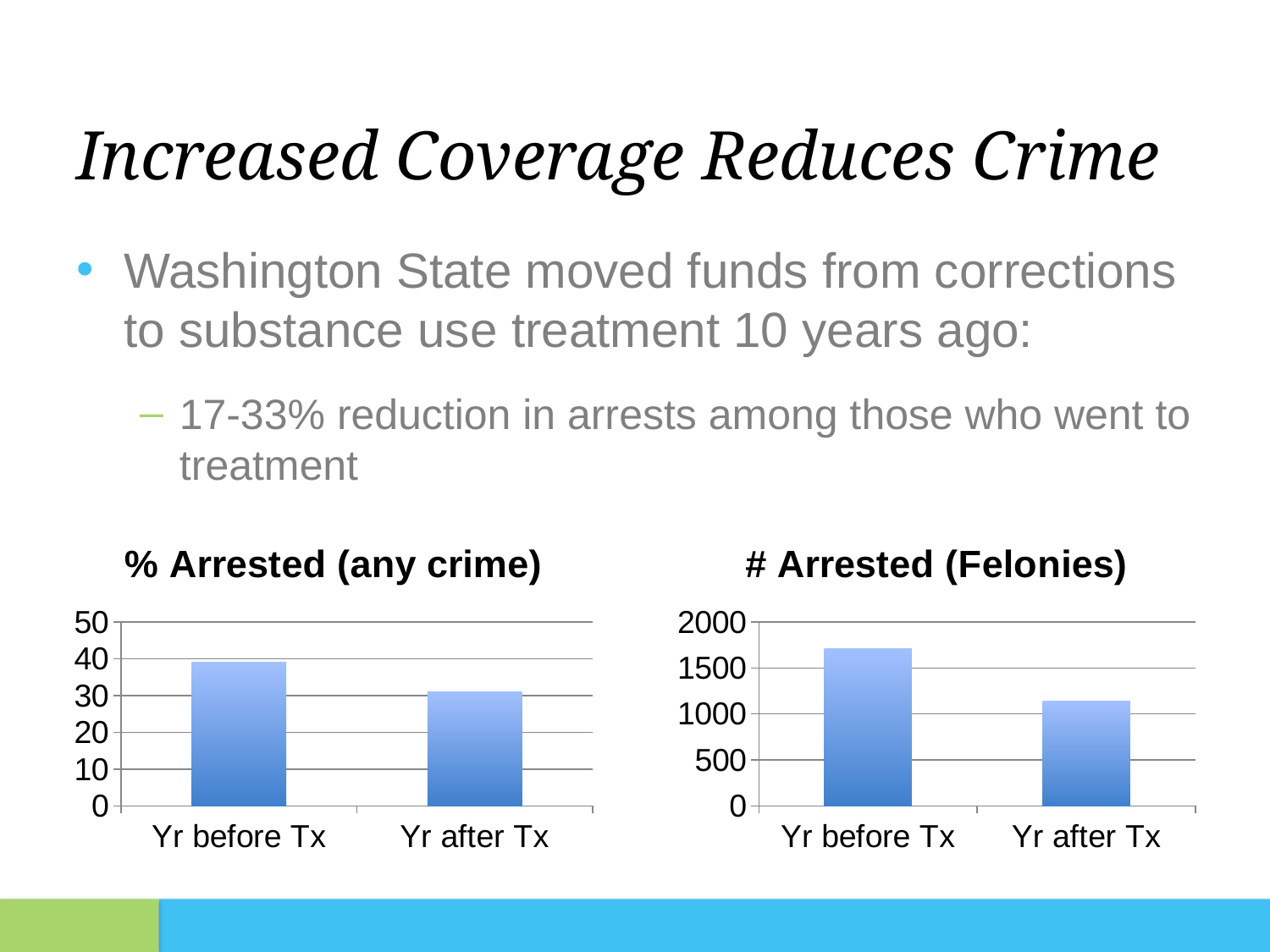
In the "% Arrested (any crime)" chart, which category has the lowest value? Yr after Tx In the "# Arrested (Felonies)" chart, is the value for Yr after Tx greater or less than 1500? less In the "# Arrested (Felonies)" chart, which category has the highest value? Yr before Tx What kind of chart is the "% Arrested (any crime)" chart? bar chart In the "# Arrested (Felonies)" chart, is the value for Yr before Tx greater or less than 1500? greater In the "% Arrested (any crime)" chart, is the value for Yr before Tx greater or less than 30? greater In the "% Arrested (any crime)" chart, is the value for Yr before Tx larger or smaller than the value for Yr after Tx? larger In the "% Arrested (any crime)" chart, which category has the highest value? Yr before Tx How many categories are shown in the "# Arrested (Felonies)" chart? 2 In the "# Arrested (Felonies)" chart, do the values rise or fall from Yr before Tx to Yr after Tx? fall